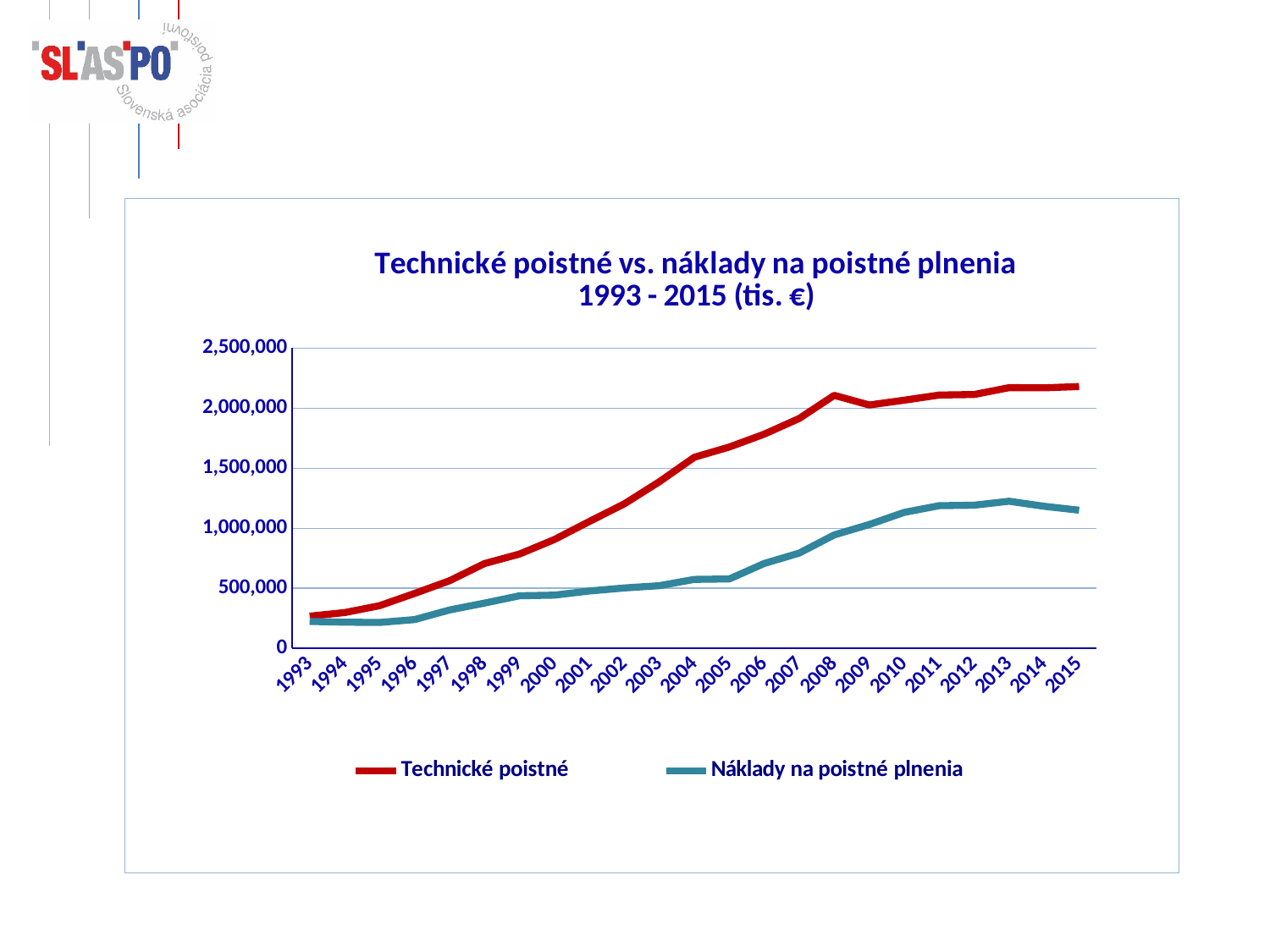
In 2015, which series has the larger value, Technické poistné or Náklady na poistné plnenia? Technické poistné Is the value for Náklady na poistné plnenia in 2000 greater or less than 500,000? less Is the value for Technické poistné in 2015 greater or less than 2,000,000? greater Is the value for Technické poistné in 2004 greater or less than 1,500,000? greater How many series does the legend list? 2 How many years are plotted along the x axis? 23 Which colour is used for the Náklady na poistné plnenia line? teal (blue-green) In which year is Technické poistné at its lowest? 1993 What is the title of the chart? Technické poistné vs. náklady na poistné plnenia 1993 - 2015 (tis. €) What kind of chart is shown on the slide? line chart